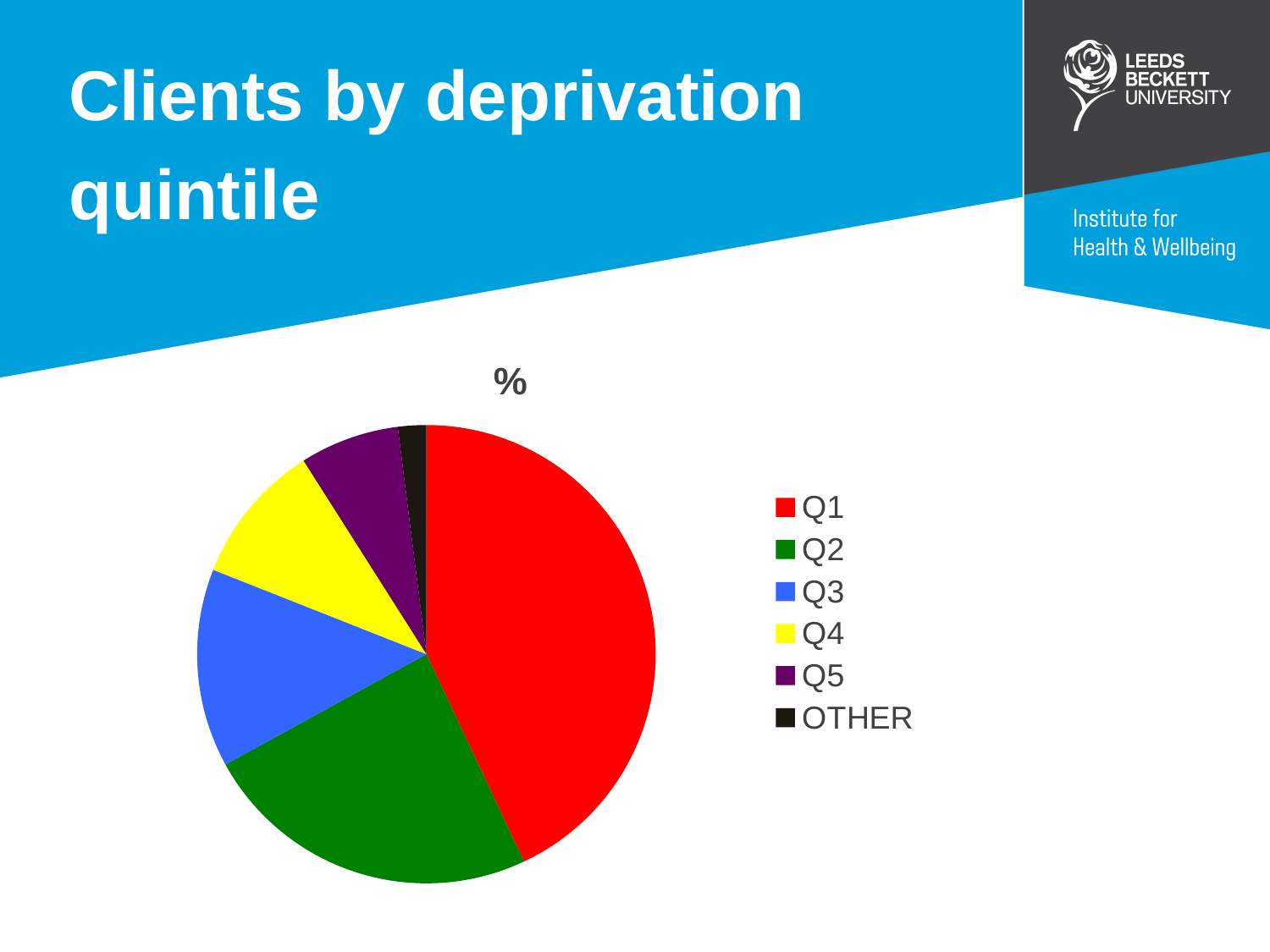
Which slice is larger, Q2 or Q4? Q2 Which category has the largest slice of the pie chart? Q1 How many categories does the pie chart show? 6 Which slice is larger, Q2 or Q3? Q2 What colour is the Q3 slice in the pie chart? Blue What kind of chart is shown on the slide? Pie chart Which category has the smallest slice of the pie chart? OTHER Which slice is larger, Q1 or Q2? Q1 What is the title shown above the pie chart? %